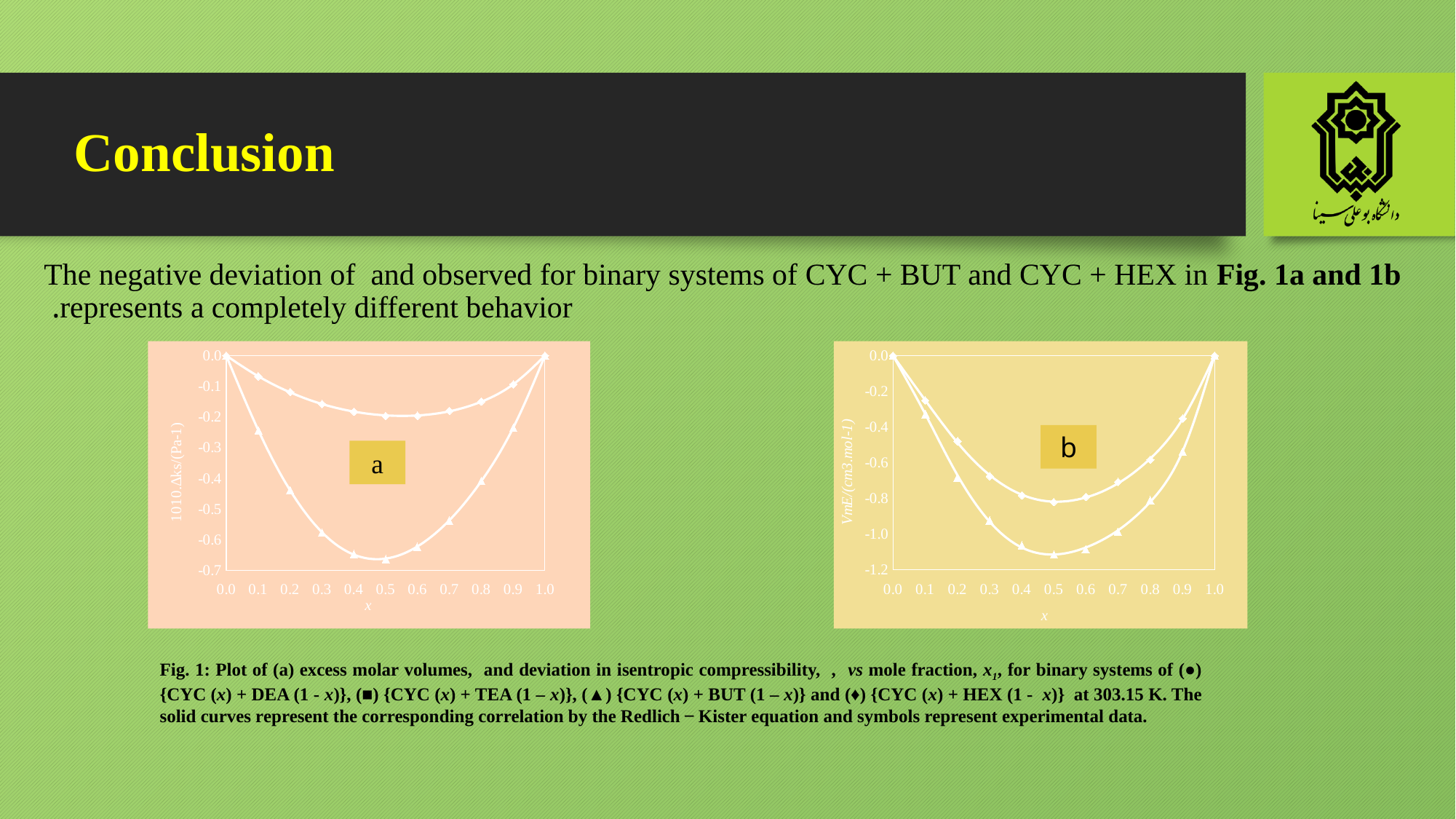
In chart a, which series is lower at x = 0.5, the triangle series or the diamond series? triangle series In chart b, do the diamond-series values rise or fall as x goes from 0.5 to 1.0? rise In chart b, is the triangle-series value at x = 0.5 greater or less than -1.0? less In chart a, do the triangle-series values rise or fall as x goes from 0.0 to 0.5? fall What kind of chart is chart a on the left? line chart How many data points does the triangle series in chart a have? 11 What is the lowest value shown on the y axis of chart b? -1.2 In chart b, which series is lower at x = 0.3, the triangle series or the diamond series? triangle series In chart a, is the diamond-series value at x = 0.5 greater or less than -0.3? greater In chart b, is the diamond-series value at x = 0.5 greater or less than -0.6? less